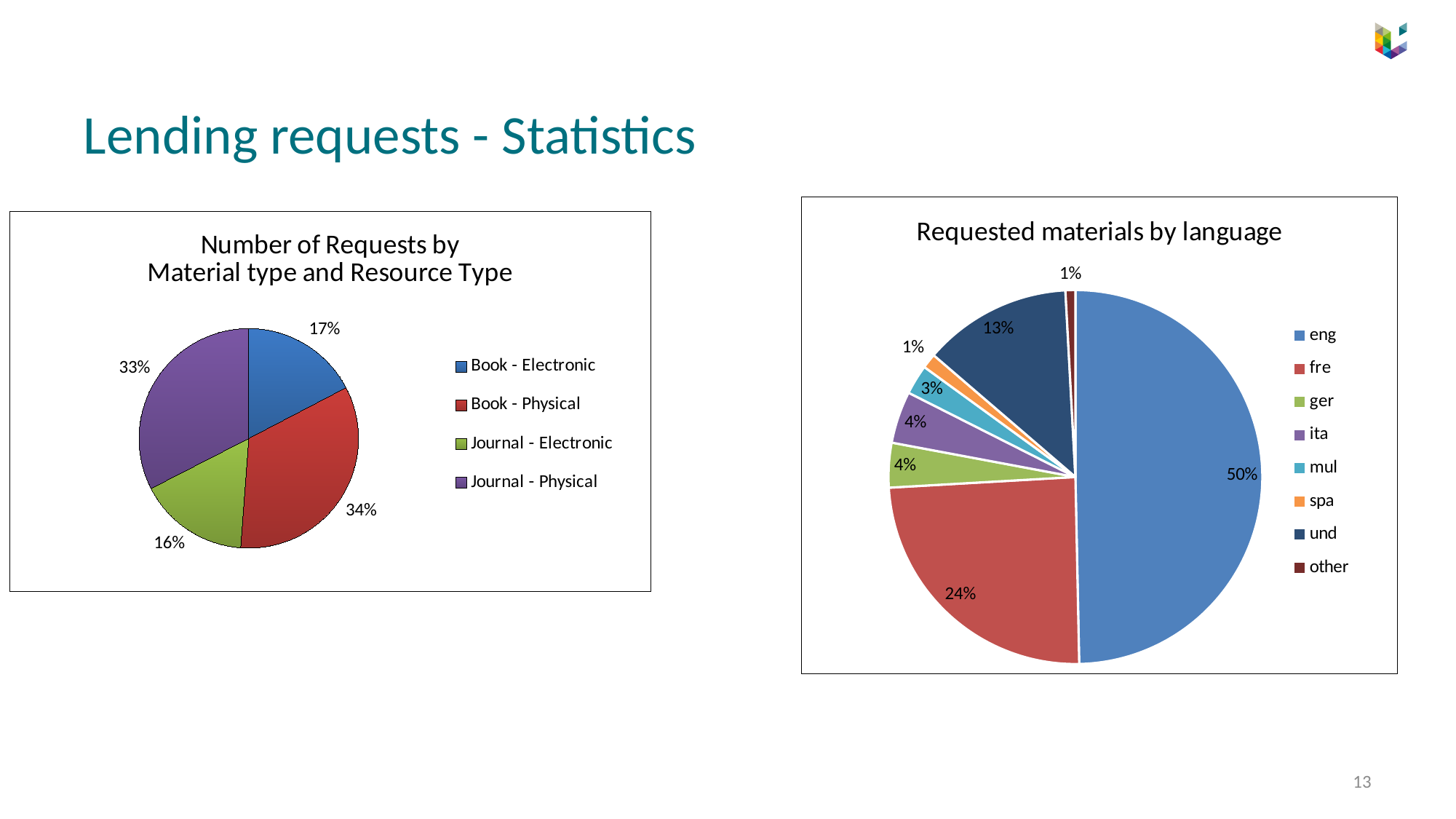
In the 'Number of Requests by Material type and Resource Type' chart, what share is Journal - Electronic? 16% In the 'Number of Requests by Material type and Resource Type' chart, which category has the largest share? Book - Physical In the 'Requested materials by language' chart, what share is und? 13% In the 'Requested materials by language' chart, how many entries does the legend list? 8 In the 'Number of Requests by Material type and Resource Type' chart, which category has the smallest share? Journal - Electronic In the 'Requested materials by language' chart, which is larger, the share of fre or the share of und? fre In the 'Requested materials by language' chart, what share is eng? 50% What kind of chart is 'Requested materials by language'? Pie chart In the 'Requested materials by language' chart, which language has the largest share? eng In the 'Requested materials by language' chart, what is the difference between the shares of eng and fre? 26 percentage points In the 'Number of Requests by Material type and Resource Type' chart, how many categories does the legend list? 4